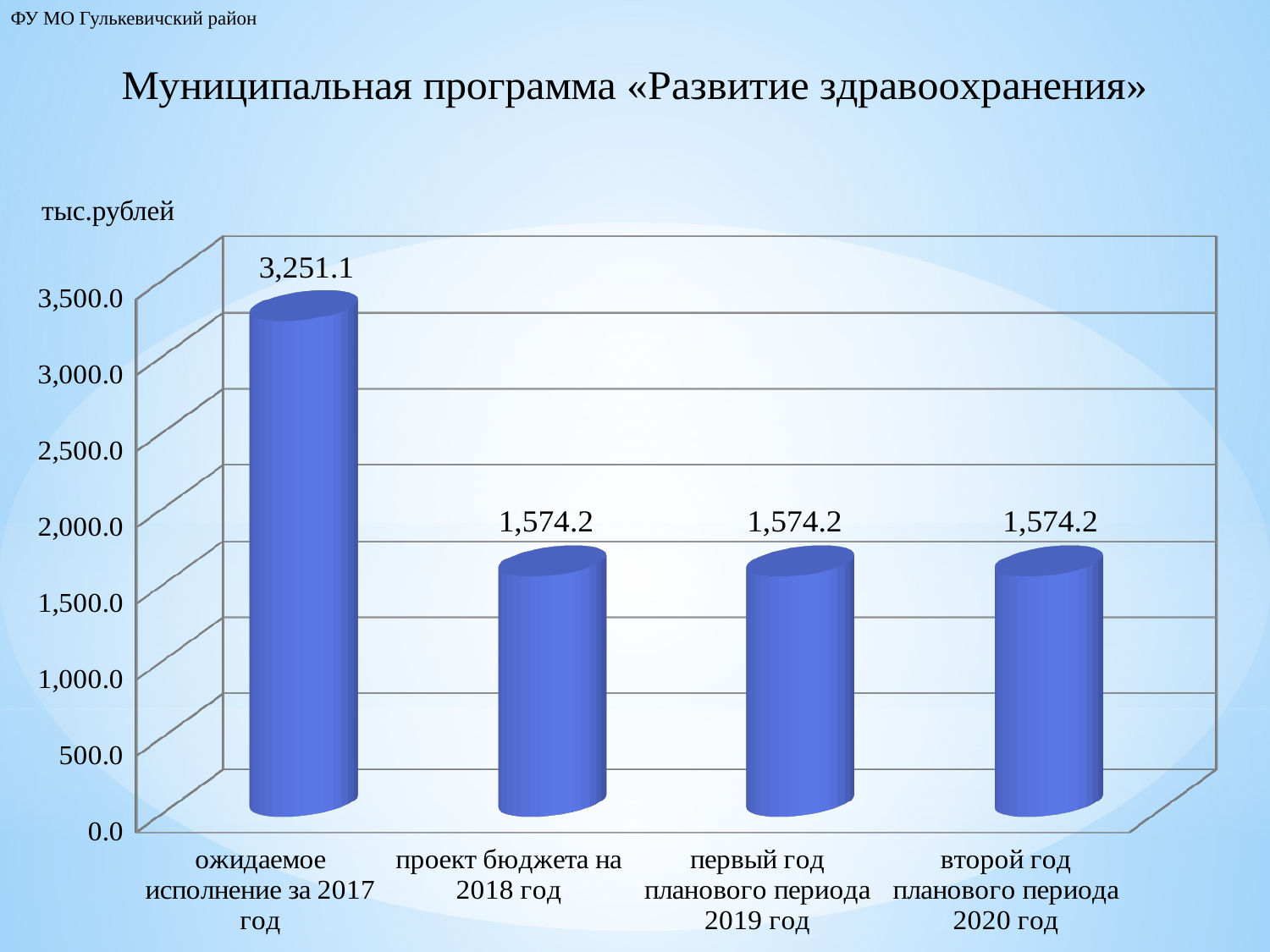
What is the value for 'второй год планового периода 2020 год'? 1,574.2 Do the values rise or fall from the first category to the second category? fall Which category has the highest value? ожидаемое исполнение за 2017 год Is the value for 'ожидаемое исполнение за 2017 год' greater or less than 3,000.0? greater What is the value for 'ожидаемое исполнение за 2017 год'? 3,251.1 What is the value for 'проект бюджета на 2018 год'? 1,574.2 What is the difference between the value for 2017 and the value for 2018? 1,676.9 What unit is indicated above the chart's vertical axis? тыс.рублей How many categories are shown on the chart? 4 What kind of chart is shown on the slide? bar chart Which is larger: the value for 'ожидаемое исполнение за 2017 год' or the value for 'первый год планового периода 2019 год'? ожидаемое исполнение за 2017 год Is the value for 'первый год планового периода 2019 год' greater or less than 2,000.0? less